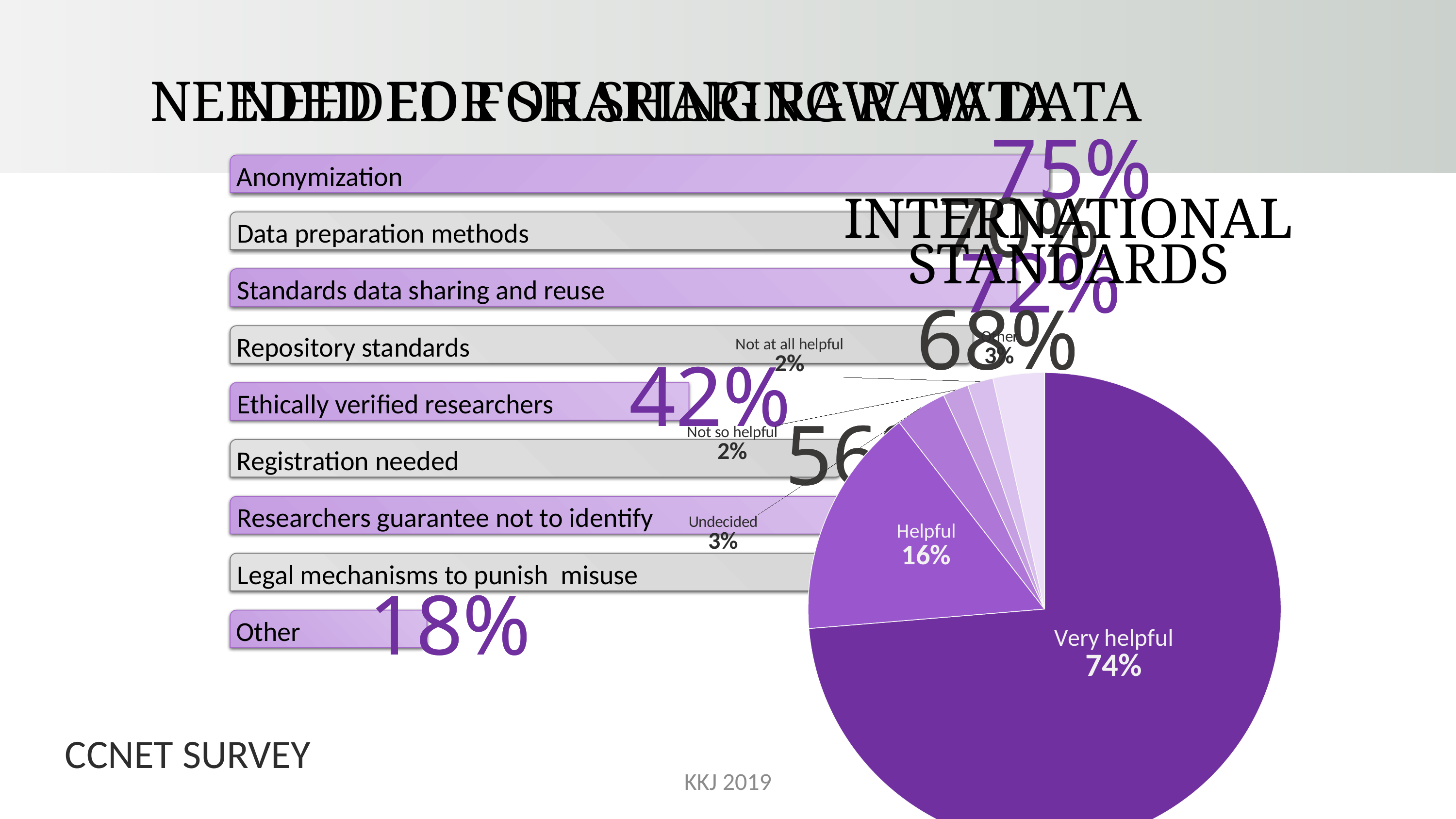
In the pie chart, which slice is the largest? Very helpful What kind of chart is the chart on the left side of the slide with categories such as Anonymization and Repository standards? bar chart In the pie chart, what share is labelled for 'Not at all helpful'? 2% What kind of chart is the chart on the right side of the slide? pie chart In the pie chart, what share is labelled for 'Helpful'? 16% In the pie chart, which is larger: 'Helpful' or 'Undecided'? Helpful In the pie chart, what share is labelled for 'Very helpful'? 74% In the pie chart, what share is labelled for 'Undecided'? 3% In the pie chart, what is the difference between the 'Very helpful' and 'Helpful' shares? 58% In the bar chart on the left, which category has the shortest bar? Other In the pie chart, what share is labelled for 'Not so helpful'? 2% In the bar chart on the left, how many categories are shown? 9